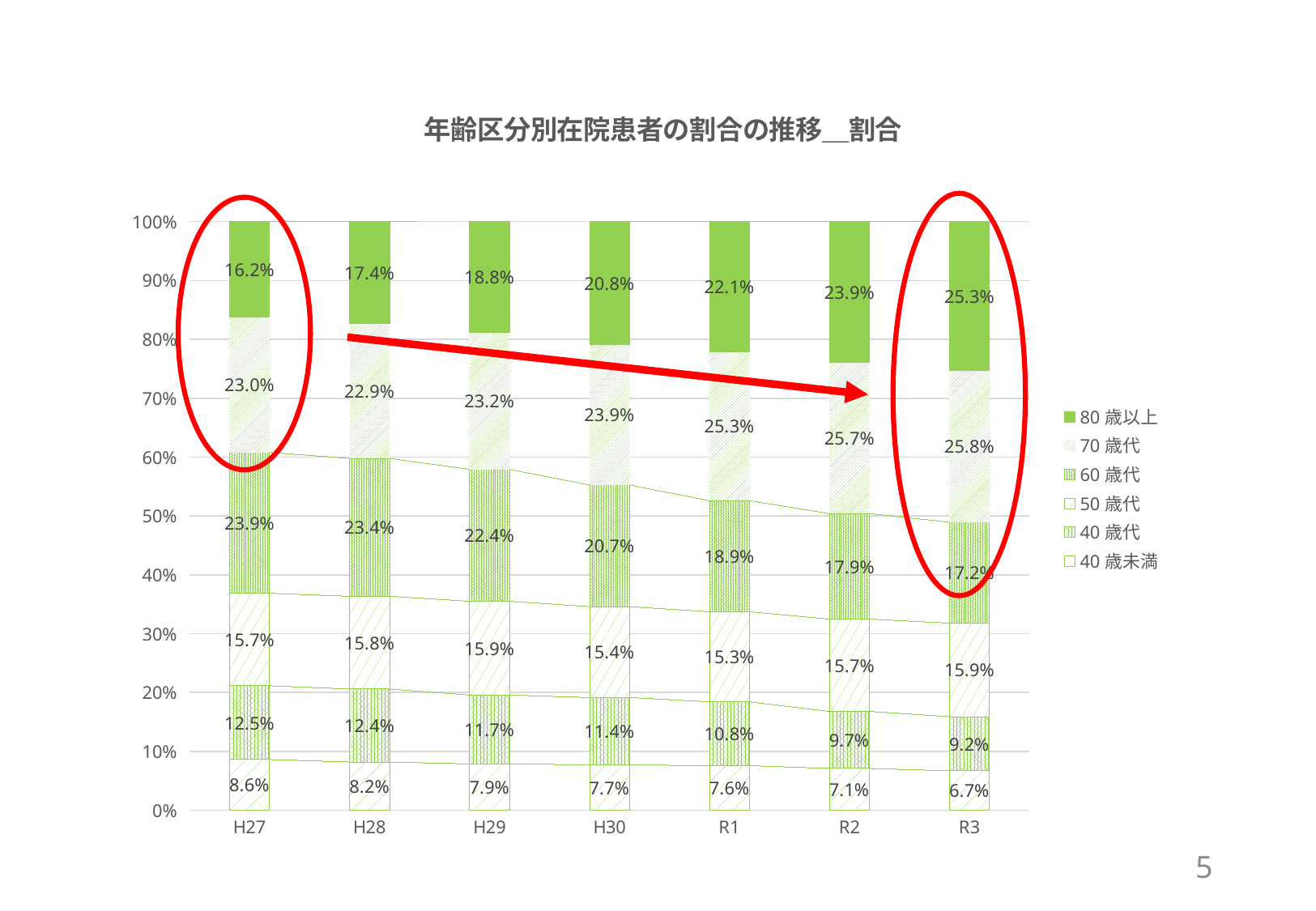
How many series does the legend list? 6 What is the value for 60歳代 in H30? 20.7% How many categories are shown on the x axis? 7 In which year is the 80歳以上 share the lowest? H27 Which is larger in R1: the 70歳代 share or the 60歳代 share? 70歳代 What is the difference between the 80歳以上 share in R3 and in H27? 9.1% Does the 40歳代 share rise or fall from H27 to R3? Fall What is the value for 80歳以上 in R3? 25.3% What is the title of the chart? 年齢区分別在院患者の割合の推移＿割合 What is the value for 40歳未満 in H27? 8.6% What type of chart is shown on the slide? Stacked bar chart In which year is the 60歳代 share the highest? H27